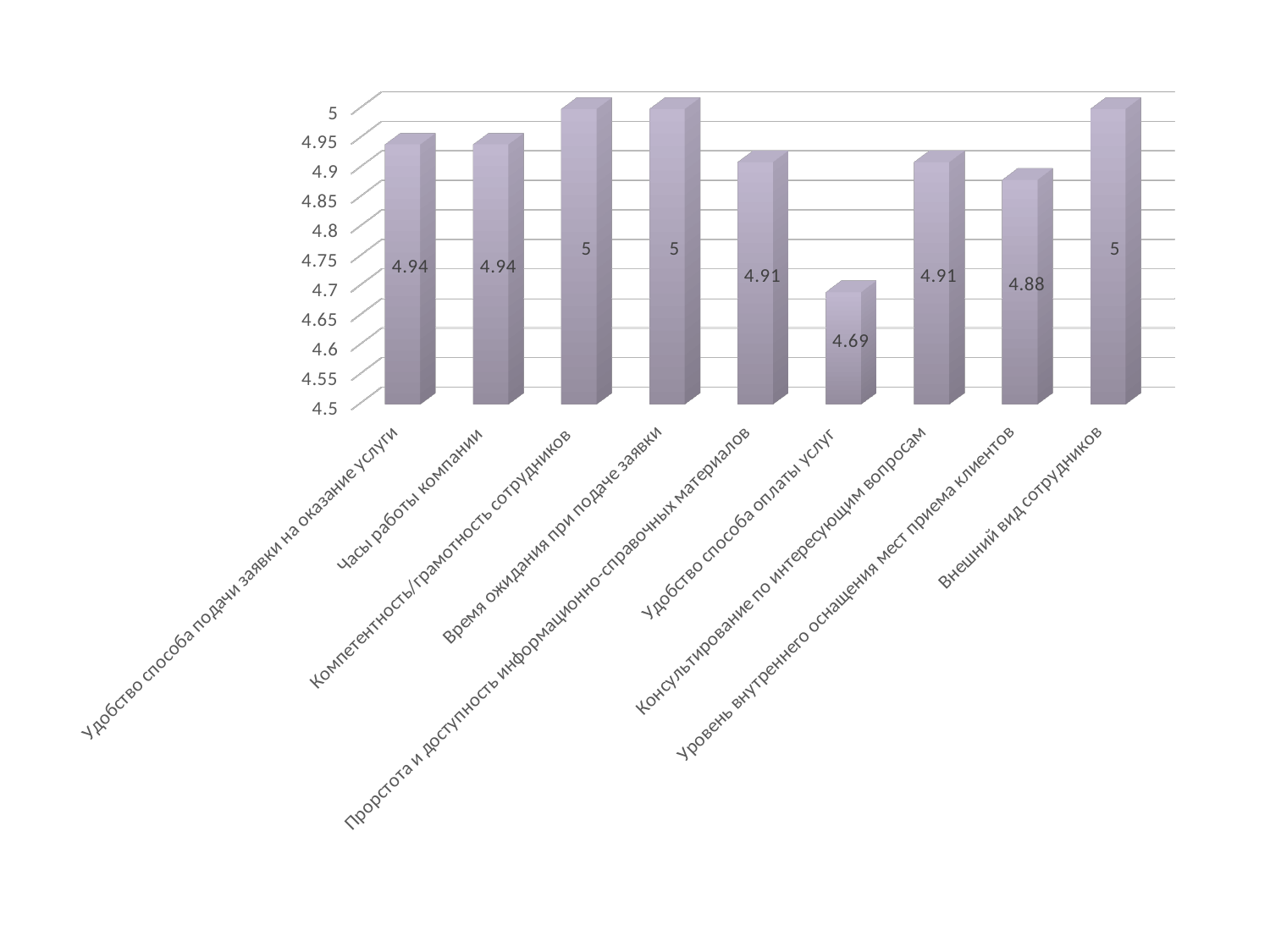
Which is larger: the value for Время ожидания при подаче заявки or the value for Консультирование по интересующим вопросам? Время ожидания при подаче заявки What is the value for Часы работы компании? 4.94 What is the value for Удобство способа оплаты услуг? 4.69 How many categories are shown in the chart? 9 What is the value for Консультирование по интересующим вопросам? 4.91 Which category has the lowest value? Удобство способа оплаты услуг What is the difference between the value for Компетентность/грамотность сотрудников and the value for Удобство способа оплаты услуг? 0.31 What is the value for Внешний вид сотрудников? 5 What is the value for Уровень внутреннего оснащения мест приема клиентов? 4.88 Is the value for Удобство способа оплаты услуг greater or less than 4.8? less What kind of chart is shown on the slide? bar chart What is the difference between the value for Удобство способа подачи заявки на оказание услуги and the value for Уровень внутреннего оснащения мест приема клиентов? 0.06